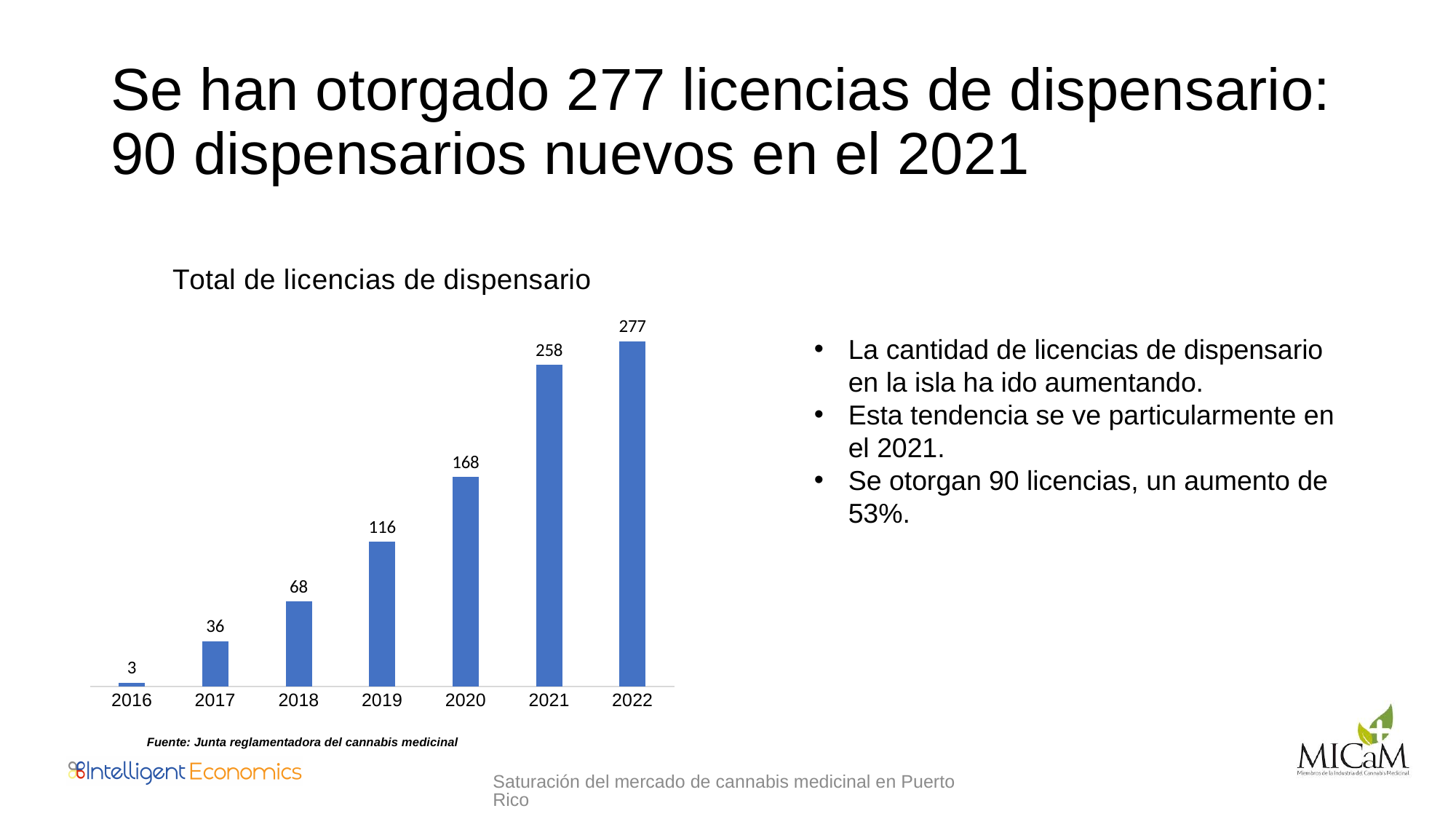
Do the values rise or fall from 2016 to 2022? Rise What is the value for 2021 in the chart? 258 What kind of chart is shown on the slide? Bar chart What is the difference between the values for 2022 and 2021? 19 What is the value for 2016 in the chart? 3 Which is larger, the value for 2018 or the value for 2019? 2019 Which year has the highest value in the chart? 2022 What is the value for 2019 in the chart? 116 What is the difference between the values for 2021 and 2020? 90 What is the title of the chart? Total de licencias de dispensario How many years are shown on the x axis of the chart? 7 Which year has the lowest value in the chart? 2016